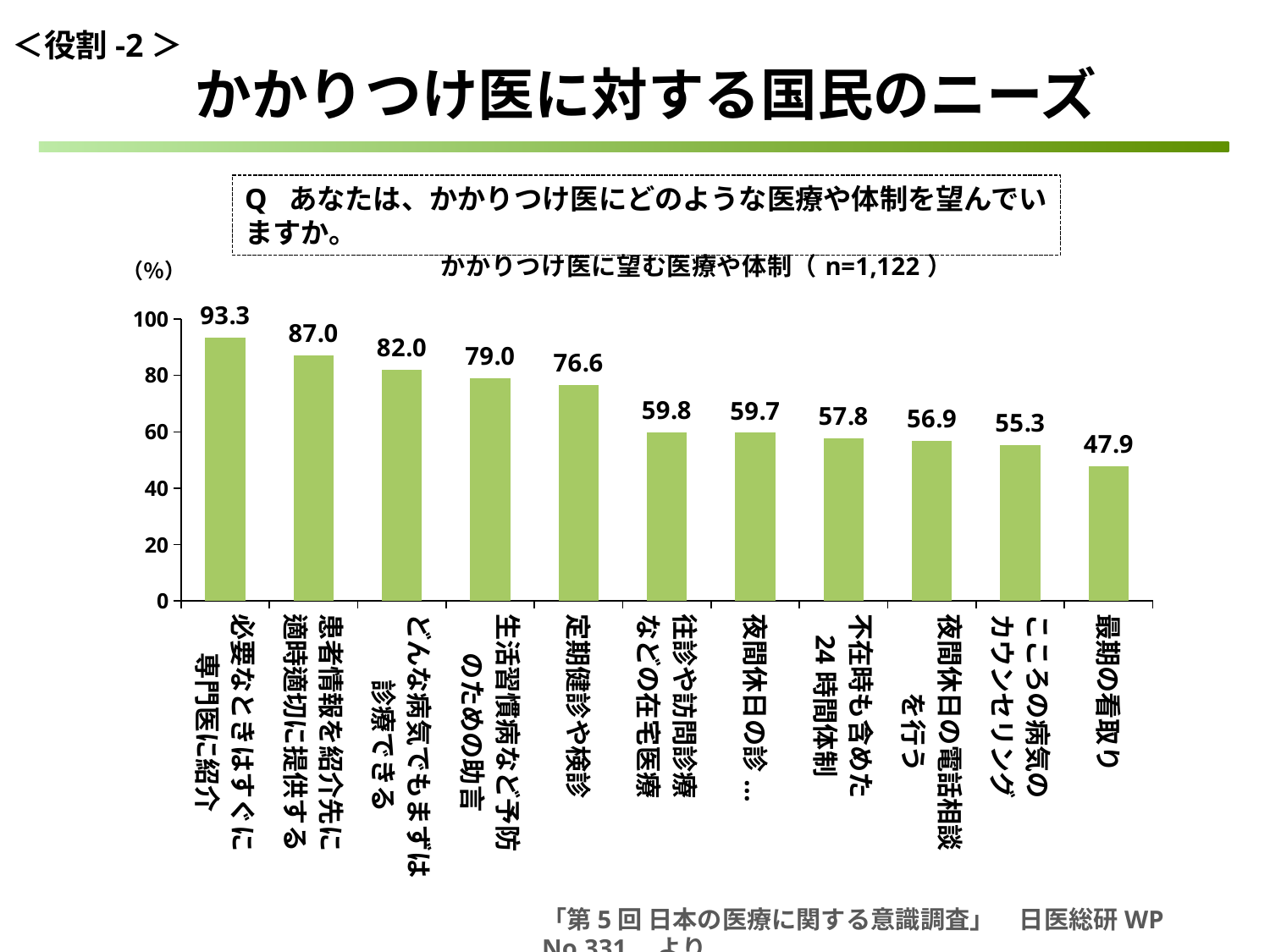
What is the difference between the values for 患者情報を紹介先に適時適切に提供する and どんな病気でもまずは診療できる? 5.0 What is the sample size (n) shown in the chart title? n=1,122 What is the value for こころの病気のカウンセリング? 55.3 What is the difference between the values for 必要なときはすぐに専門医に紹介 and 最期の看取り? 45.4 How many categories are shown in the chart? 11 What is the value for 必要なときはすぐに専門医に紹介? 93.3 What is the value for 定期健診や検診? 76.6 Which category has the highest value? 必要なときはすぐに専門医に紹介 What is the value for 最期の看取り? 47.9 Which category has the lowest value? 最期の看取り What kind of chart is shown on the slide? bar chart Which is larger, the value for 生活習慣病など予防のための助言 or the value for 不在時も含めた24時間体制? 生活習慣病など予防のための助言